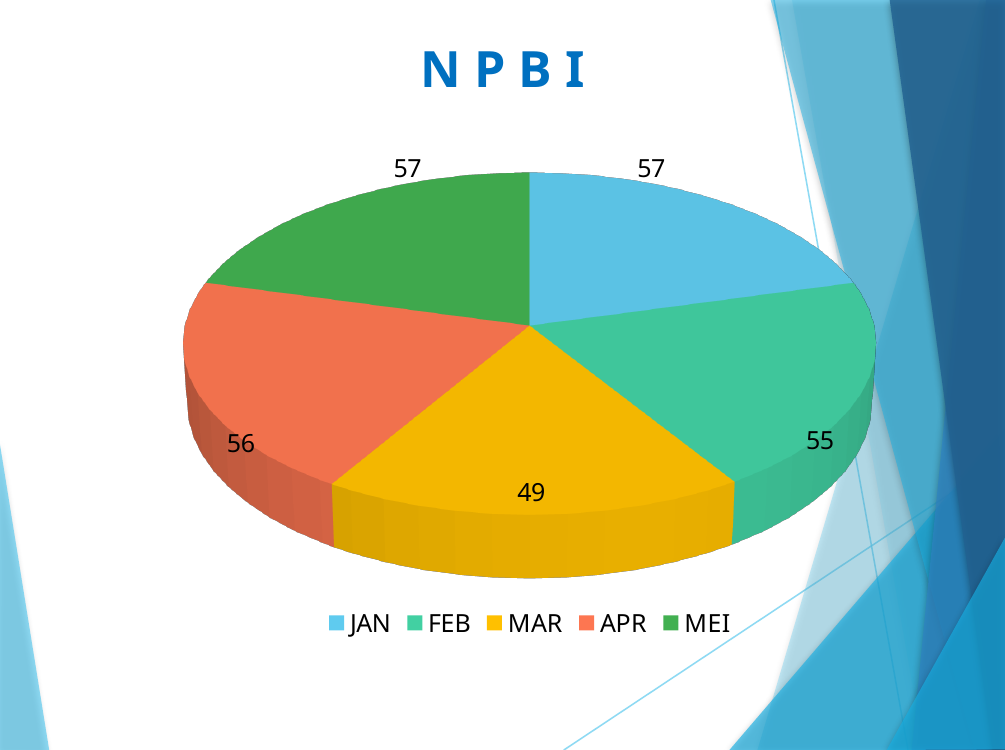
What is the value for APR? 56 What is the value for FEB? 55 What is the value for JAN? 57 How many slices does the pie chart have? 5 How many entries does the legend list? 5 What is the value for MAR? 49 What is the total of all the slice values? 274 What is the difference between the values for JAN and MAR? 8 What is the title of the chart? NPBI What type of chart is shown on the slide? pie chart Which is larger, the value for APR or the value for MAR? APR Which category has the lowest value? MAR